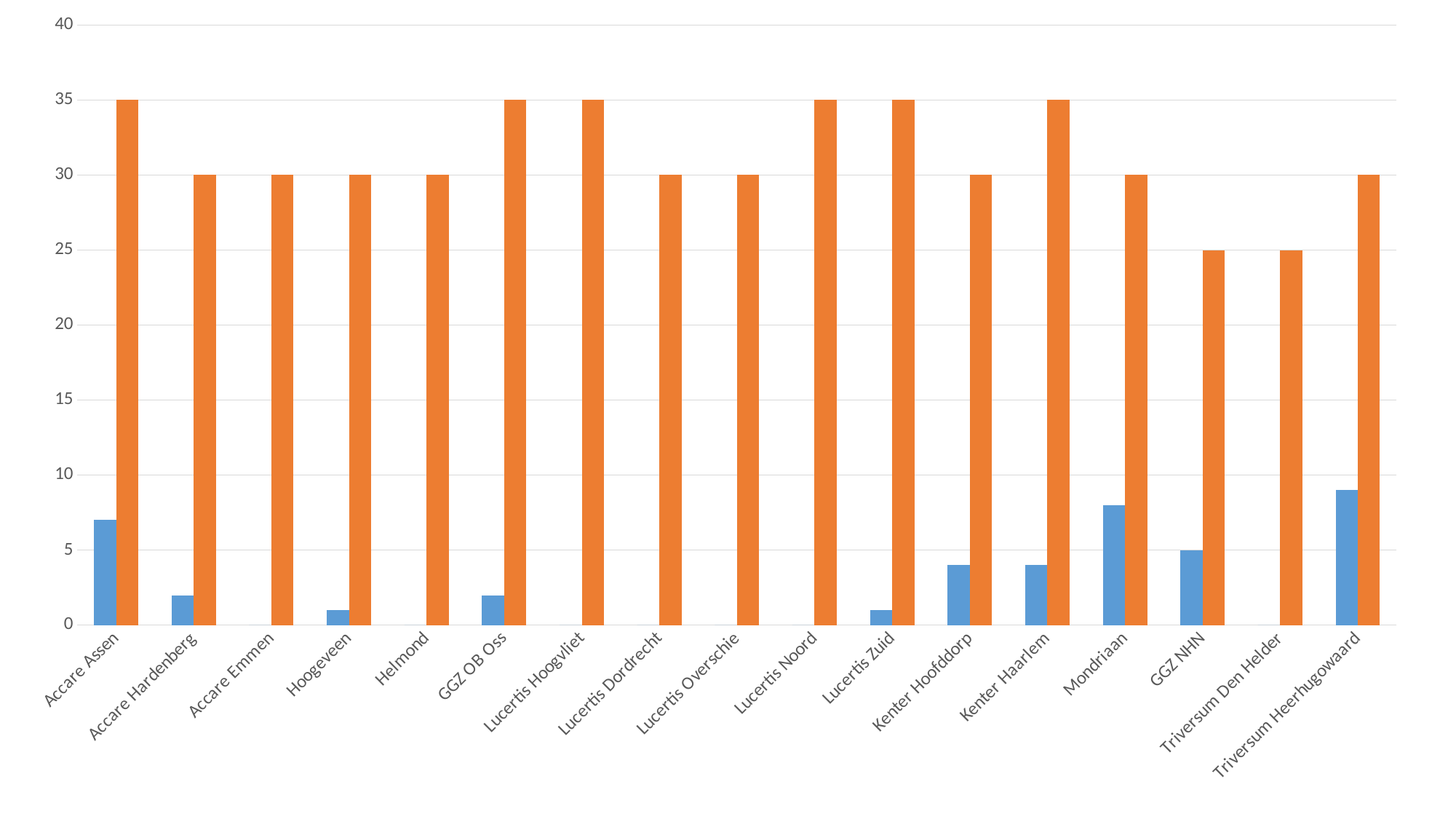
What is the difference between the orange bar for Accare Assen and the orange bar for GGZ NHN? 10 How many categories are shown along the x axis? 17 Is the value of the blue bar for Accare Hardenberg greater or less than 5? less Which category has the tallest blue bar? Triversum Heerhugowaard Is the value of the blue bar for Mondriaan greater or less than 5? greater What kind of chart is shown on the slide? bar chart What is the value of the orange bar for GGZ NHN? 25 What is the value of the orange bar for Triversum Den Helder? 25 Which has the larger orange bar, Accare Assen or Accare Emmen? Accare Assen What is the value of the orange bar for Accare Hardenberg? 30 What is the value of the orange bar for Accare Assen? 35 Is the value of the blue bar for Accare Assen greater or less than 5? greater